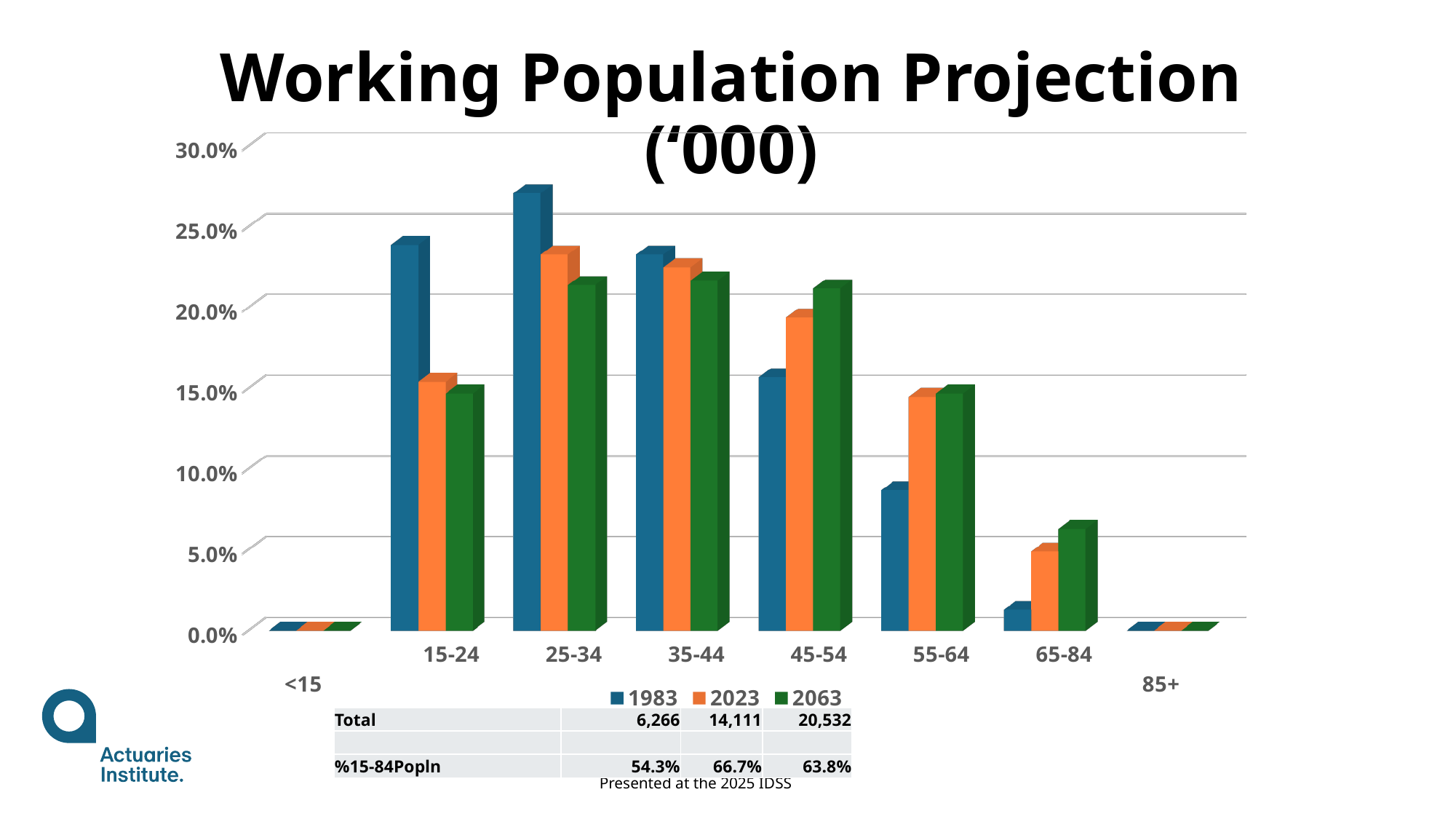
Which age group has the highest value for the 2023 series? 25-34 For the 55-64 age group, which series has the larger value, 1983 or 2023? 2023 Is the 1983 value for 15-24 greater or less than 20.0%? greater Is the 2023 value for 15-24 greater or less than 20.0%? less Which age group has the highest value for the 1983 series? 25-34 Is the 2063 value for 65-84 greater or less than 5.0%? greater How many age-group categories are shown on the x axis? 8 For the 45-54 age group, which series has the larger value, 1983 or 2063? 2063 Do the 1983 values rise or fall across the age groups from 25-34 to 65-84? fall What kind of chart is shown on the slide? bar chart How many series does the legend list? 3 What is the title of the chart? Working Population Projection ('000)